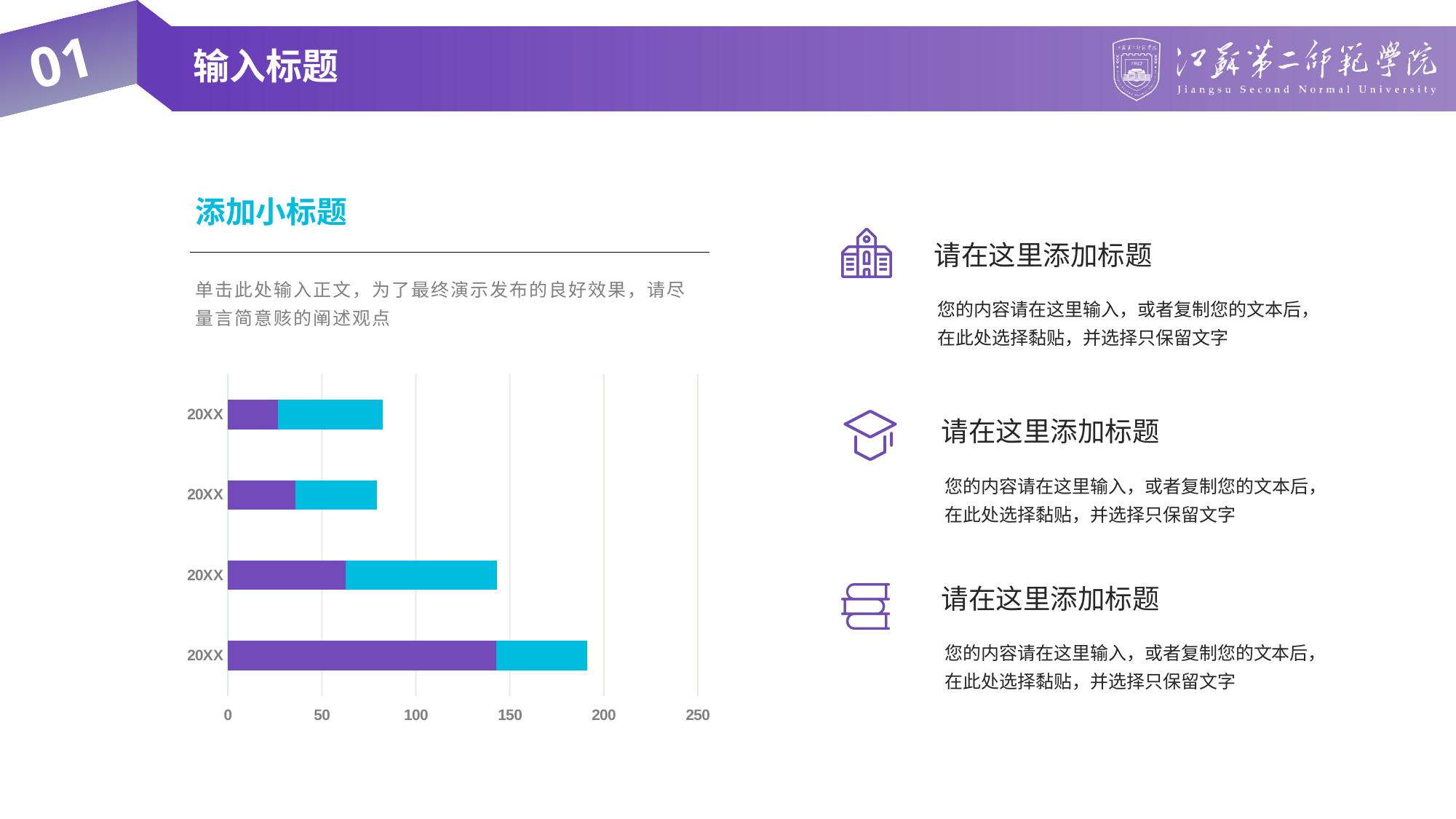
Is the total value of the bottom bar greater or less than 150? greater Which is longer, the bottom bar or the third bar from the top? The bottom bar What kind of chart is shown on the slide? Bar chart How many coloured segments make up each bar in the chart? 2 What label is shown for each category on the vertical axis? 20XX How many bars does the chart have? 4 Is the total value of the second bar from the top greater or less than 100? less Is the total value of the top bar greater or less than 100? less Which bar in the chart is the longest? The bottom bar Which is longer, the top bar or the third bar from the top? The third bar from the top What is the highest value shown on the horizontal axis? 250